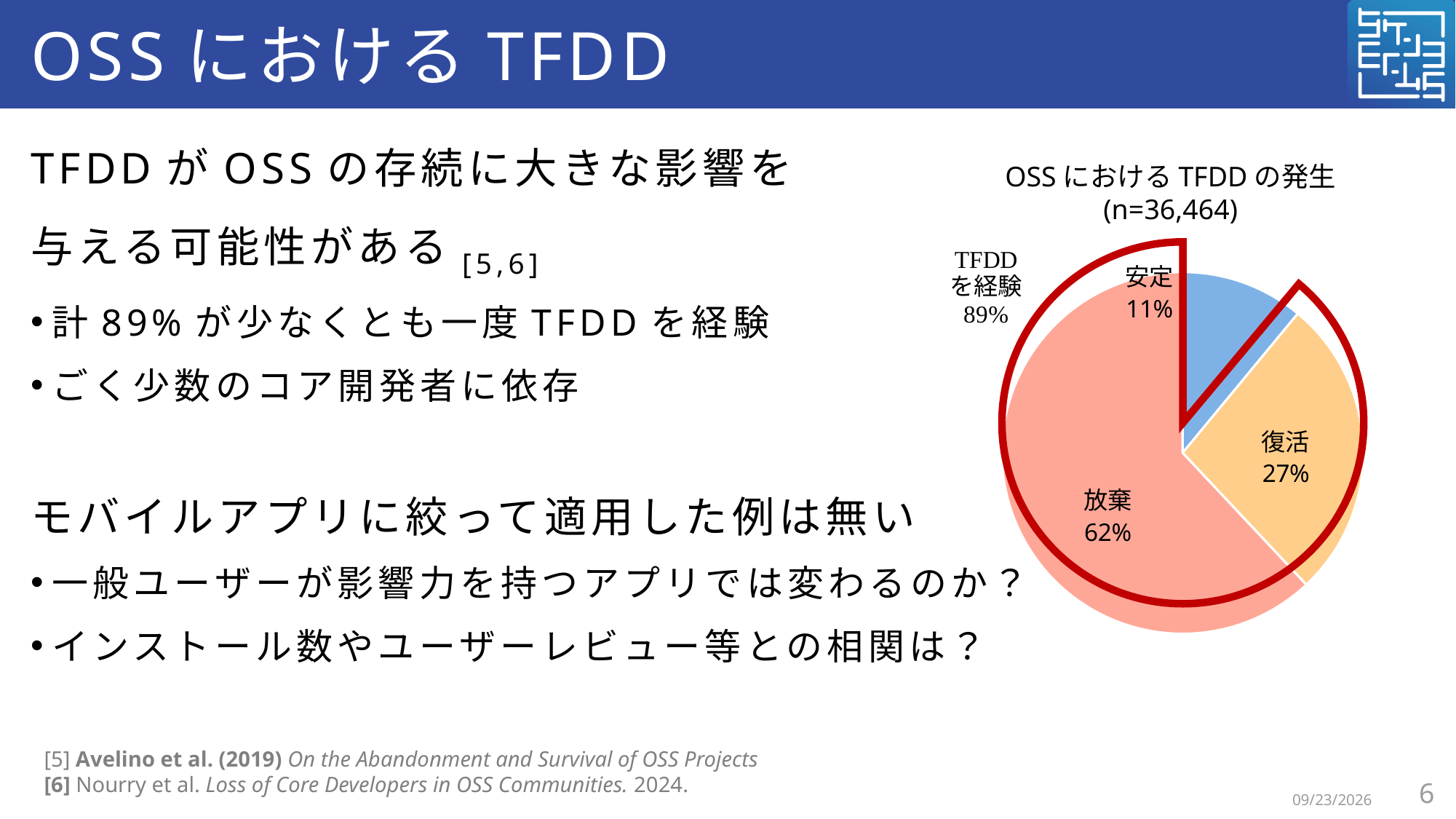
Which is larger, the 復活 slice or the 安定 slice? 復活 What combined share is labelled as TFDD を経験 on the chart? 89% What percentage does the 復活 slice represent? 27% What kind of chart is shown on the slide? pie chart What is the title of the pie chart? OSS における TFDD の発生 (n=36,464) Which category has the largest share of the pie? 放棄 How many slices does the pie chart have? 3 What is the difference in percentage points between 放棄 and 復活? 35 What percentage does the 安定 slice represent? 11% Which category has the smallest share of the pie? 安定 What is the sample size (n) stated in the chart title? 36,464 What percentage does the 放棄 slice represent? 62%